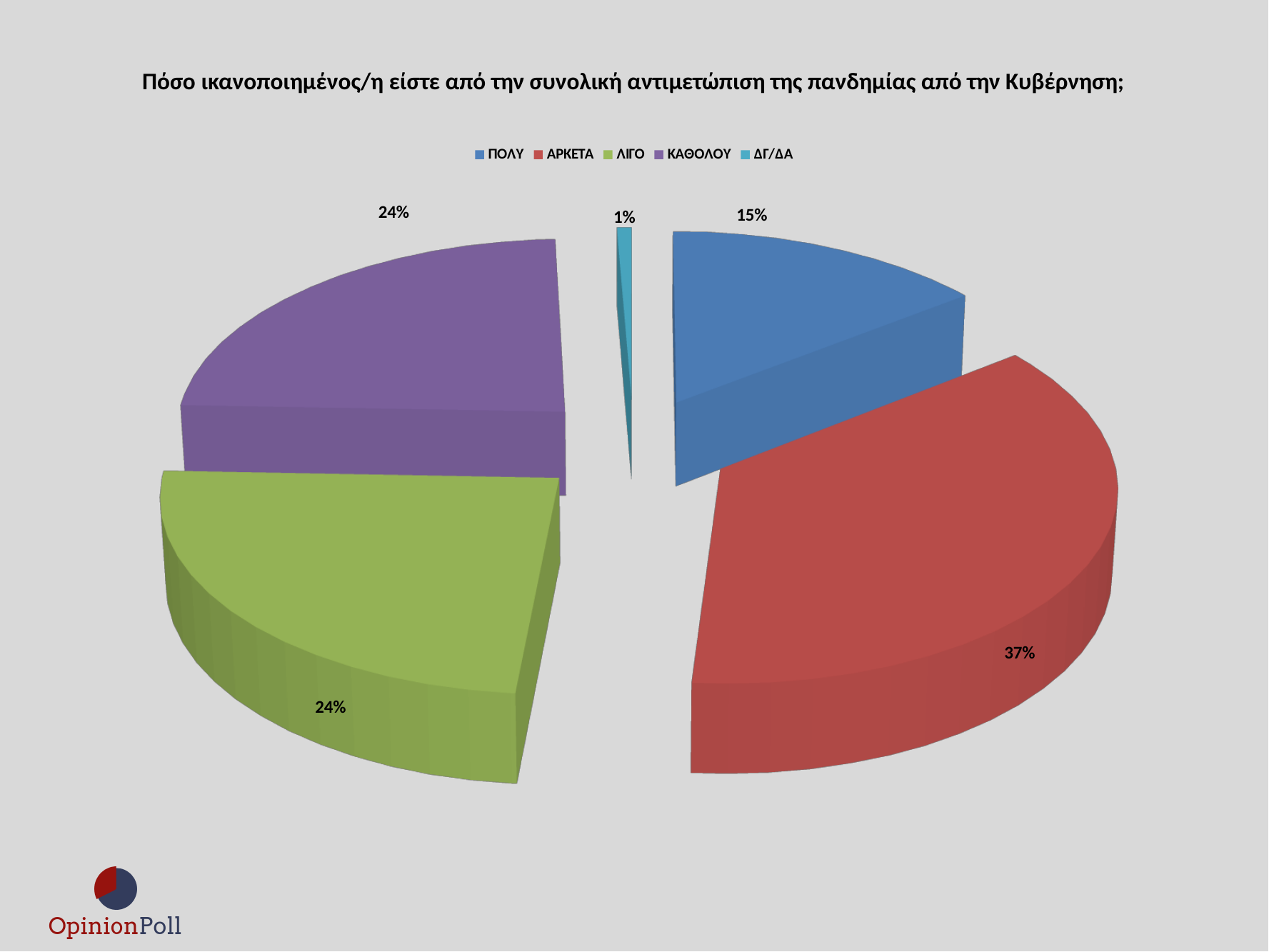
What percentage of respondents answered ΑΡΚΕΤΑ? 37% Which response has the smallest share of the pie? ΔΓ/ΔΑ Which response has the largest share of the pie? ΑΡΚΕΤΑ How many slices does the pie chart have? 5 What percentage of respondents answered ΔΓ/ΔΑ? 1% What kind of chart is shown on the slide? pie chart What percentage of respondents answered ΠΟΛΥ? 15% What is the difference in percentage points between ΑΡΚΕΤΑ and ΠΟΛΥ? 22 What percentage of respondents answered ΛΙΓΟ? 24% What colour is the slice for ΚΑΘΟΛΟΥ? purple How many entries does the legend list? 5 Which is larger, the share for ΑΡΚΕΤΑ or the share for ΚΑΘΟΛΟΥ? ΑΡΚΕΤΑ